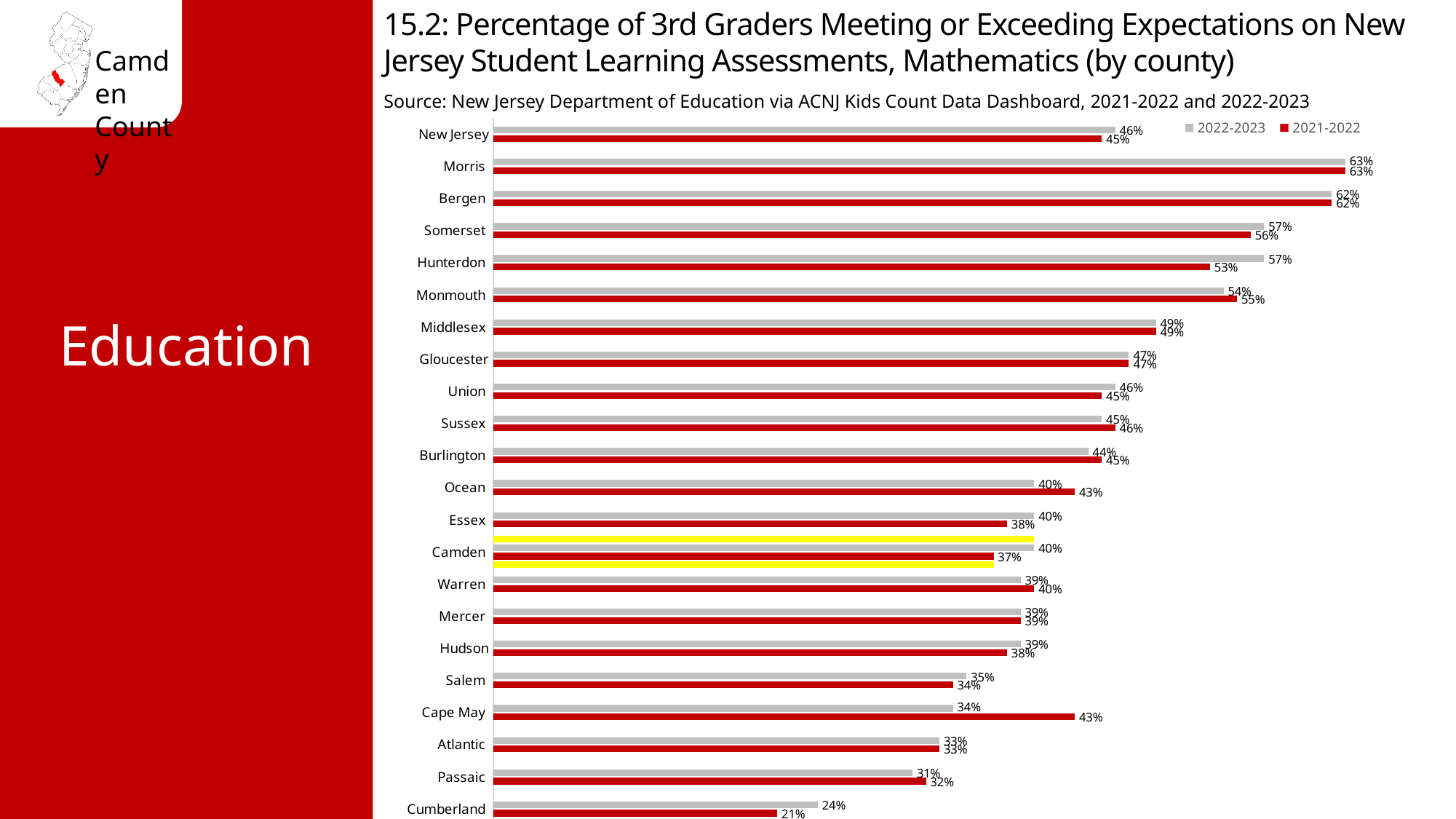
For Hunterdon, which series has the larger value, 2022-2023 or 2021-2022? 2022-2023 What is the value for Camden in the 2022-2023 series? 40% Which is larger, Ocean's 2021-2022 value or Essex's 2021-2022 value? Ocean's 2021-2022 value What is the value for Cape May in the 2021-2022 series? 43% Which county has the lowest value in the 2022-2023 series? Cumberland What is the value for Cumberland in the 2021-2022 series? 21% How many categories (counties plus New Jersey) are shown on the chart? 22 What is the difference between Cape May's 2021-2022 value and its 2022-2023 value? 9 percentage points What is the difference between Camden's 2022-2023 value and its 2021-2022 value? 3 percentage points What kind of chart is shown on the slide? Bar chart How many series does the legend list? 2 Which county has the highest value in the 2022-2023 series? Morris